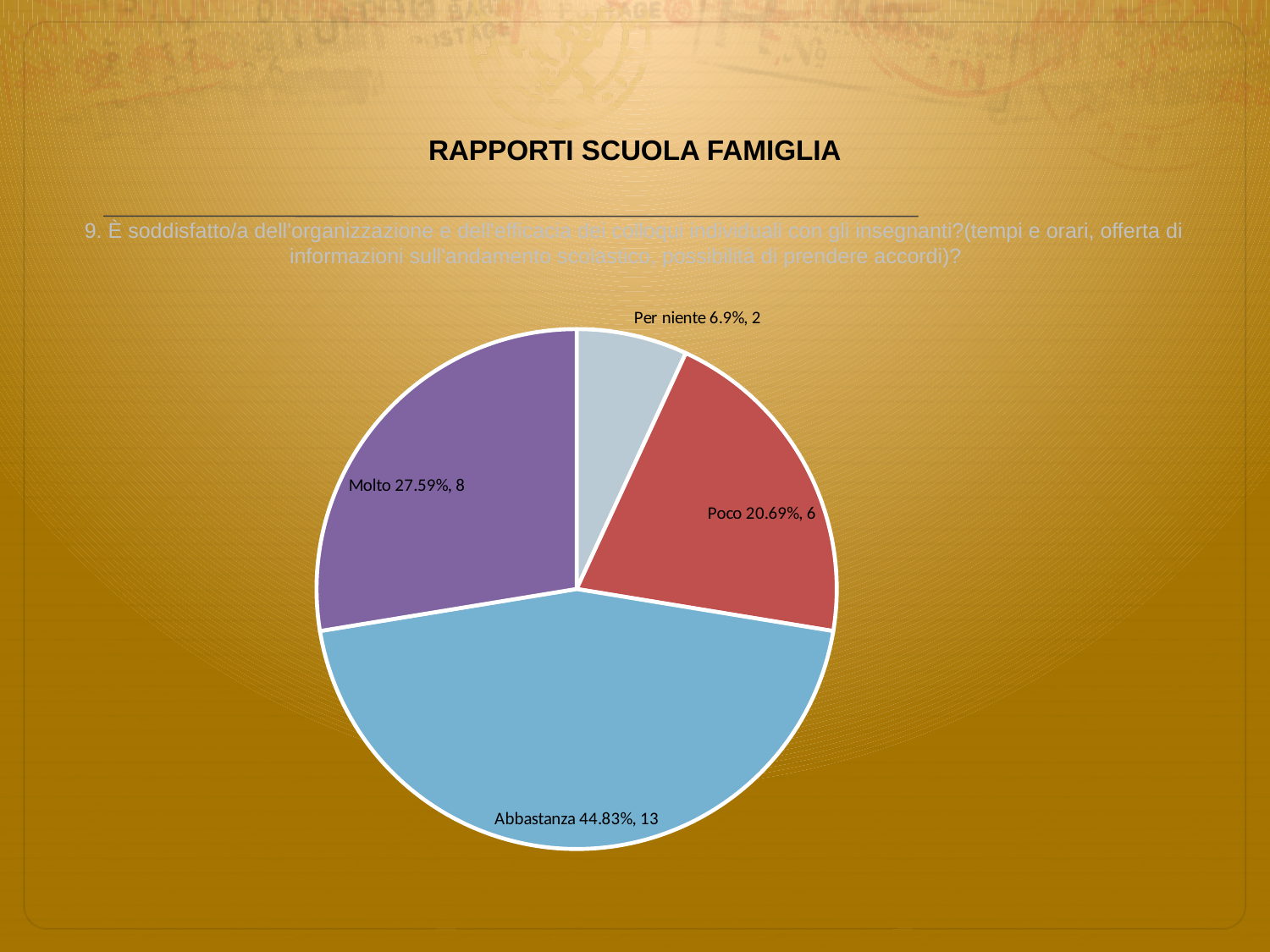
Which category has the smallest slice? Per niente What is the total count across all slices? 29 Which category has the largest slice? Abbastanza What colour is the 'Abbastanza' slice? blue Which is larger, the 'Molto' slice or the 'Poco' slice? Molto What is the count shown for 'Per niente'? 2 What is the count shown for 'Molto'? 8 What is the difference in count between 'Abbastanza' and 'Molto'? 5 What kind of chart is shown on the slide? pie chart How many slices does the pie chart have? 4 What percentage share does the 'Poco' slice have? 20.69% What percentage share does the 'Abbastanza' slice have? 44.83%